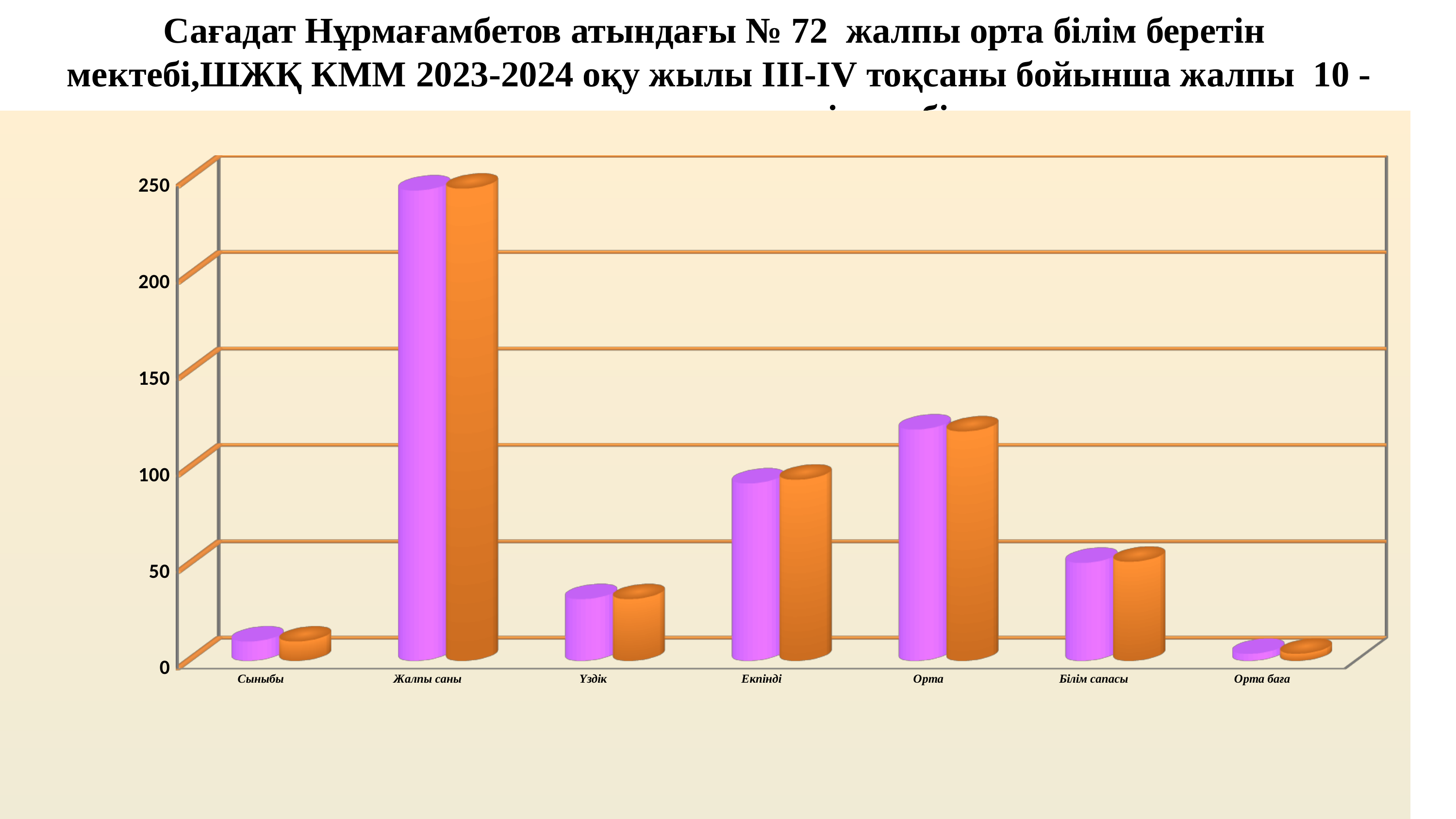
Which category has the lowest bars in the chart? Орта баға What kind of chart is shown on the slide? bar chart What two colours are used for the bars in the chart? purple and orange Which is larger, the value for Білім сапасы or the value for Үздік? Білім сапасы How many categories are shown on the x axis of the chart? 7 Is the value for Екпінді greater or less than 100? less Which is larger, the value for Орта or the value for Екпінді? Орта Is the value for Жалпы саны greater or less than 200? greater Is the value for Үздік greater or less than 50? less Which category has the highest bars in the chart? Жалпы саны